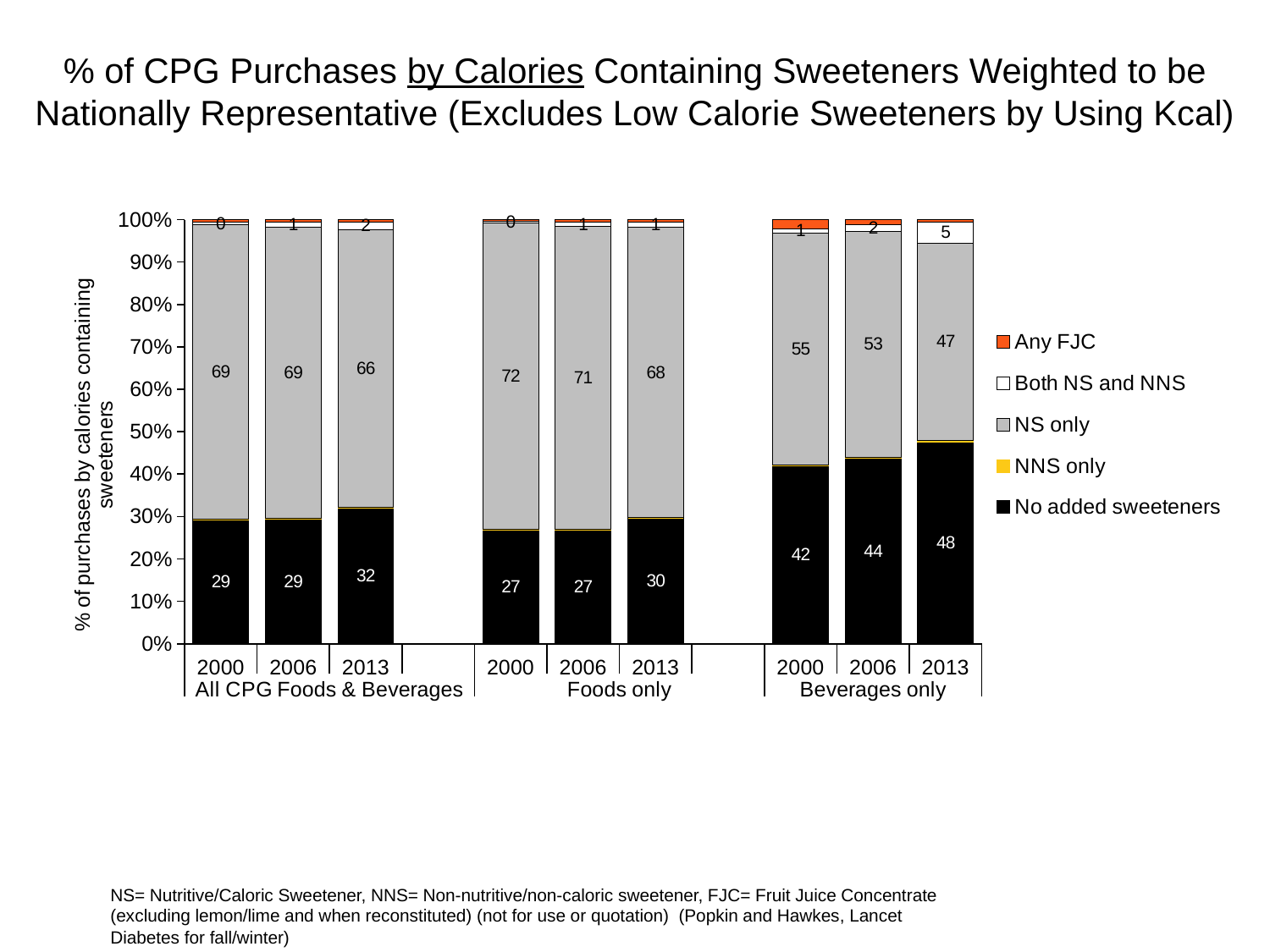
What kind of chart is shown on the slide? Stacked bar chart Which bar has the lowest "NS only" value? Beverages only, 2013 Which is larger: the "No added sweeteners" value for Beverages only in 2000 or for Foods only in 2000? Beverages only in 2000 What is the value for "No added sweeteners" in the 2013 bar of the Beverages only group? 48 What is the value for "NS only" in the 2000 bar of the Foods only group? 72 Within the Beverages only group, does the "No added sweeteners" value rise or fall from 2000 to 2013? Rise How many bars are plotted in the chart? 9 Which bar has the highest "No added sweeteners" value? Beverages only, 2013 What is the value for "NS only" in the 2013 bar of the All CPG Foods & Beverages group? 66 What is the difference between the "NS only" values for Foods only in 2000 and 2013? 4 How many series does the legend list? 5 What is the value for "Both NS and NNS" in the 2013 bar of the Beverages only group? 5